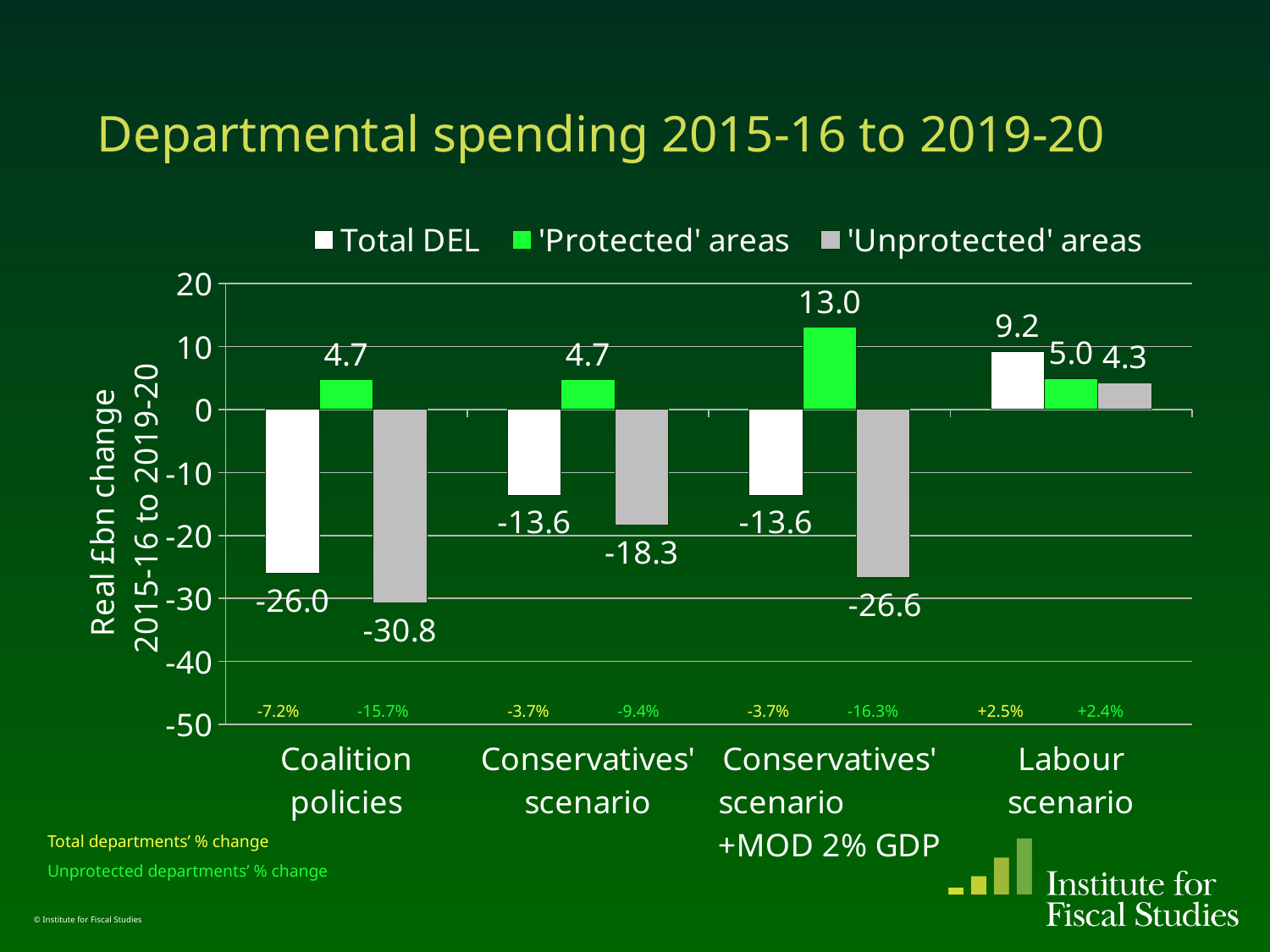
What is the 'Unprotected' areas value for the Conservatives' scenario? -18.3 What is the Total DEL value for Coalition policies? -26.0 Which category has the highest 'Protected' areas value? Conservatives' scenario +MOD 2% GDP What is the title of the chart on the slide? Departmental spending 2015-16 to 2019-20 What is the 'Protected' areas value for the Conservatives' scenario +MOD 2% GDP? 13.0 What is the difference between the 'Unprotected' areas values for Coalition policies and the Conservatives' scenario? 12.5 Which is larger: the 'Protected' areas value for the Labour scenario or for the Conservatives' scenario? Labour scenario What is the Total DEL value for the Labour scenario? 9.2 How many series does the legend list? 3 How many categories are shown on the x axis? 4 What kind of chart is shown on the slide? Bar chart Which category has the lowest 'Unprotected' areas value? Coalition policies